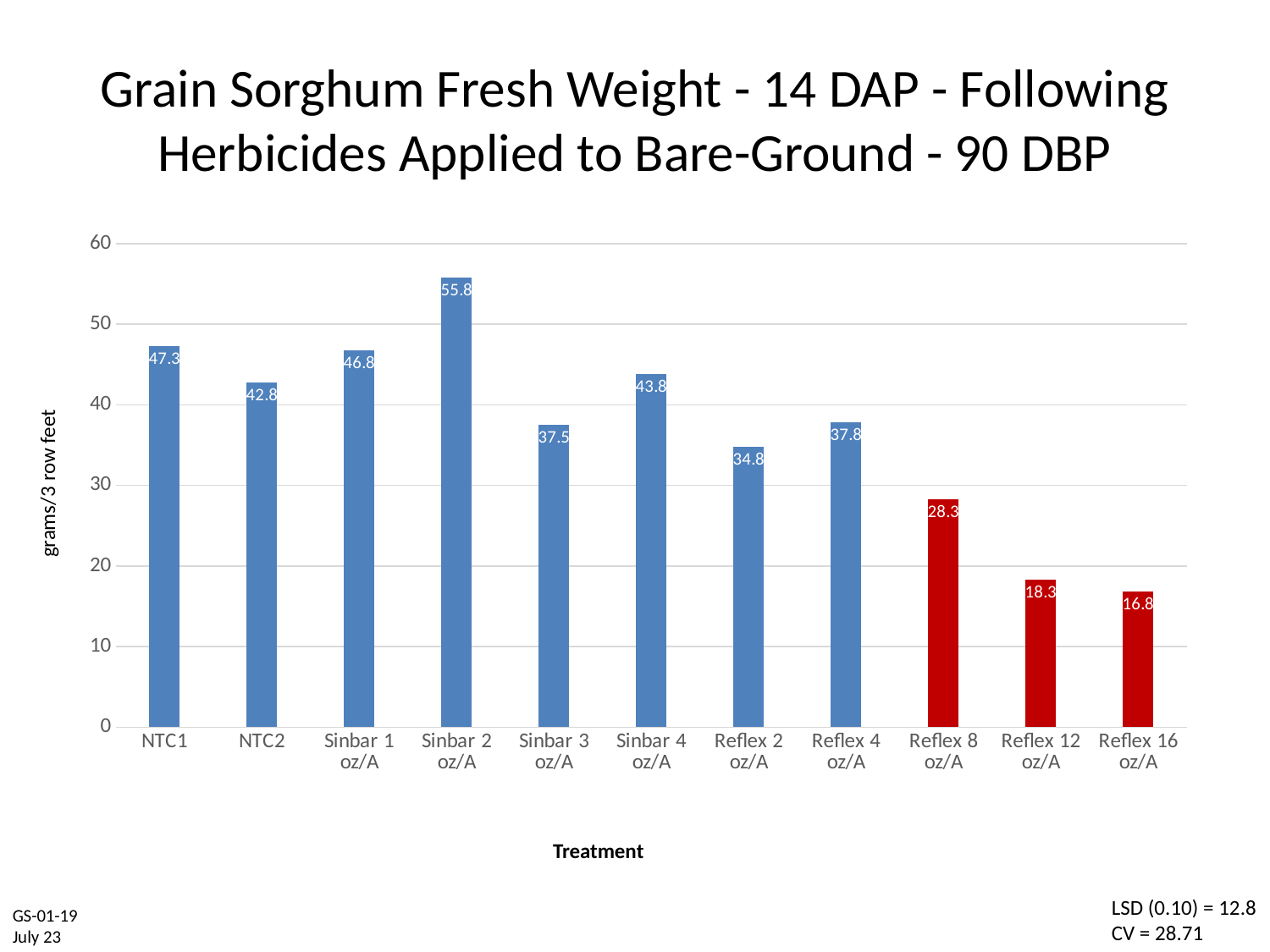
What is the label of the y axis? grams/3 row feet Is the value for Reflex 12 oz/A greater or less than 20? less What kind of chart is shown on the slide? bar chart What is the fresh weight value for NTC1? 47.3 What is the fresh weight value for Reflex 8 oz/A? 28.3 What is the fresh weight value for Sinbar 2 oz/A? 55.8 Which treatment has the lowest fresh weight? Reflex 16 oz/A What is the difference in fresh weight between Sinbar 2 oz/A and Reflex 16 oz/A? 39 Which has a larger fresh weight, Sinbar 4 oz/A or Reflex 4 oz/A? Sinbar 4 oz/A How many treatments are shown on the x axis? 11 What is the difference in fresh weight between NTC1 and NTC2? 4.5 Which treatment has the highest fresh weight? Sinbar 2 oz/A